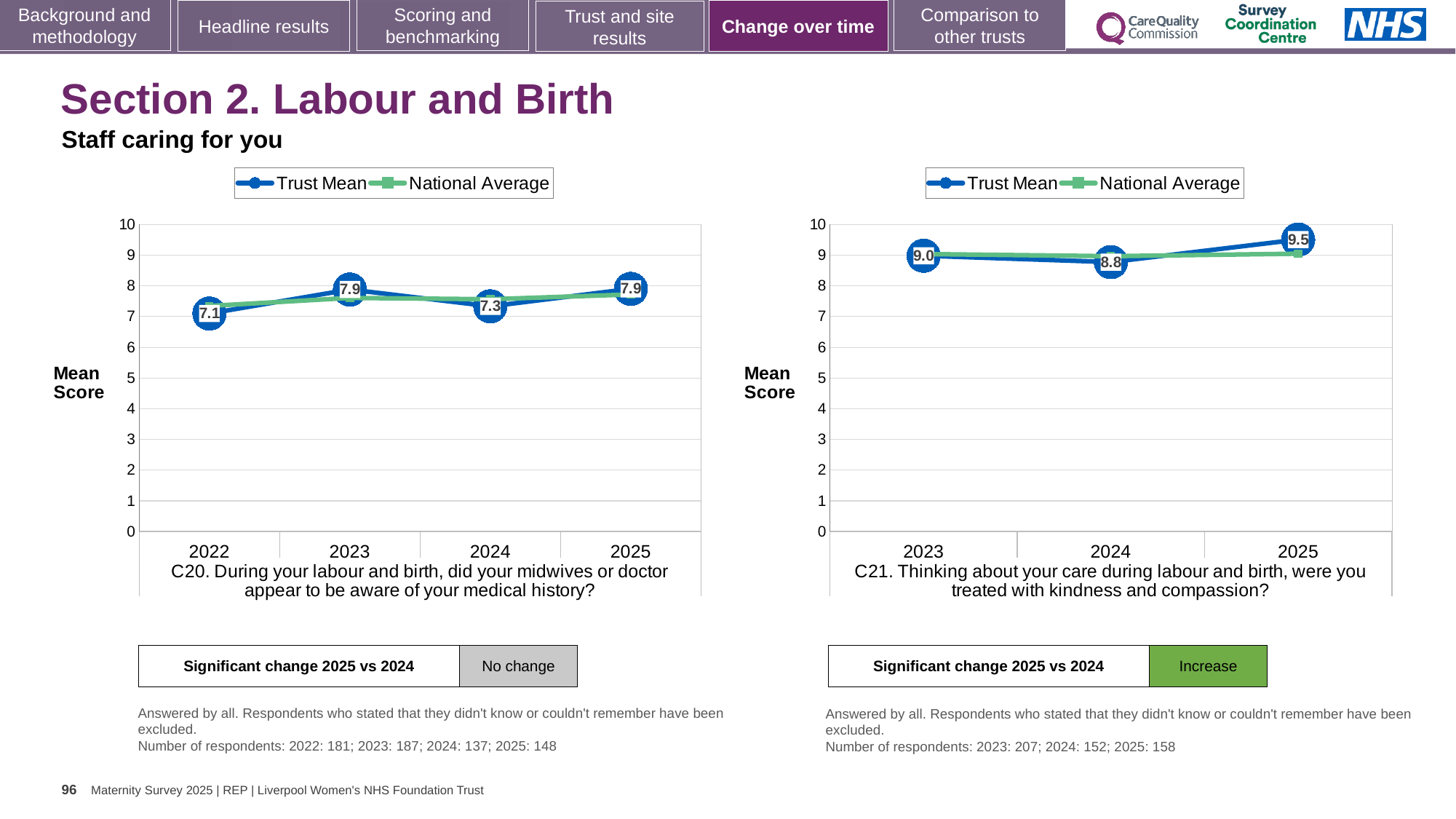
In the C20 chart (left), what is the Trust Mean for 2022? 7.1 In the C20 chart (left), what is the Trust Mean for 2024? 7.3 In the C20 chart (left), which year has the lowest Trust Mean? 2022 How many series does the legend of the C20 chart (left) list? 2 In the C21 chart (right), what is the difference between the Trust Mean for 2025 and 2024? 0.7 In the C21 chart (right), what is the Trust Mean for 2025? 9.5 In the C20 chart (left), is the Trust Mean for 2022 greater or less than 8? less What type of chart is the C21 chart (right)? line chart How many years are plotted on the x axis of the C21 chart (right)? 3 In the C21 chart (right), which year has the highest Trust Mean? 2025 In the C21 chart (right), what is the Trust Mean for 2024? 8.8 In the C20 chart (left), is the Trust Mean for 2023 larger or smaller than the Trust Mean for 2024? larger